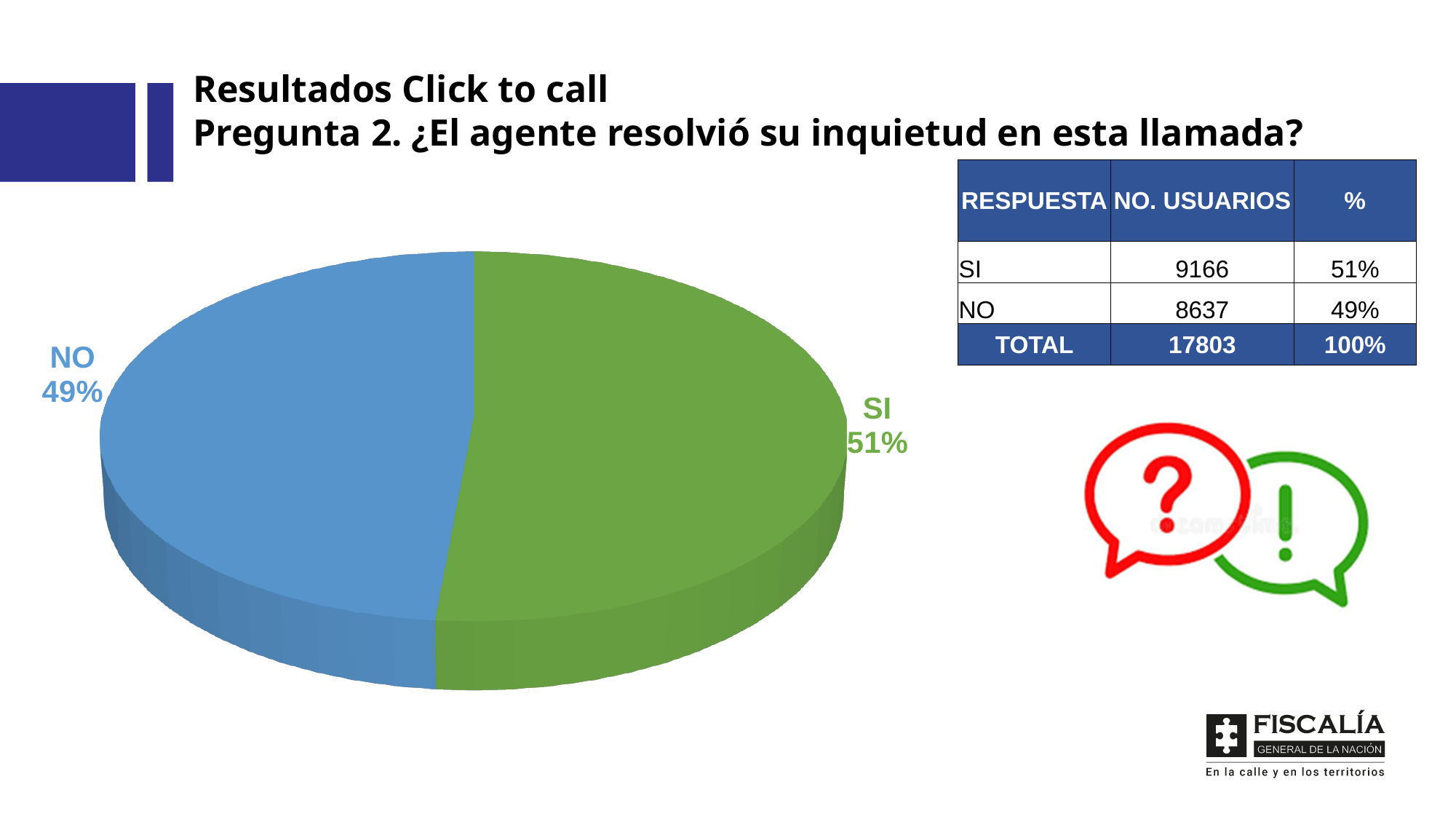
How many slices does the pie chart have? 2 Which is larger, the SI slice or the NO slice? SI What kind of chart is shown on the slide? pie chart Which slice of the pie is the smallest? NO What is the difference in percentage points between the SI and NO slices? 2% What share of the pie does the NO slice represent? 49% What colour is the NO slice of the pie chart? blue Is the share for NO greater or less than 50%? less What share of the pie does the SI slice represent? 51% Which slice of the pie is the largest? SI What colour is the SI slice of the pie chart? green